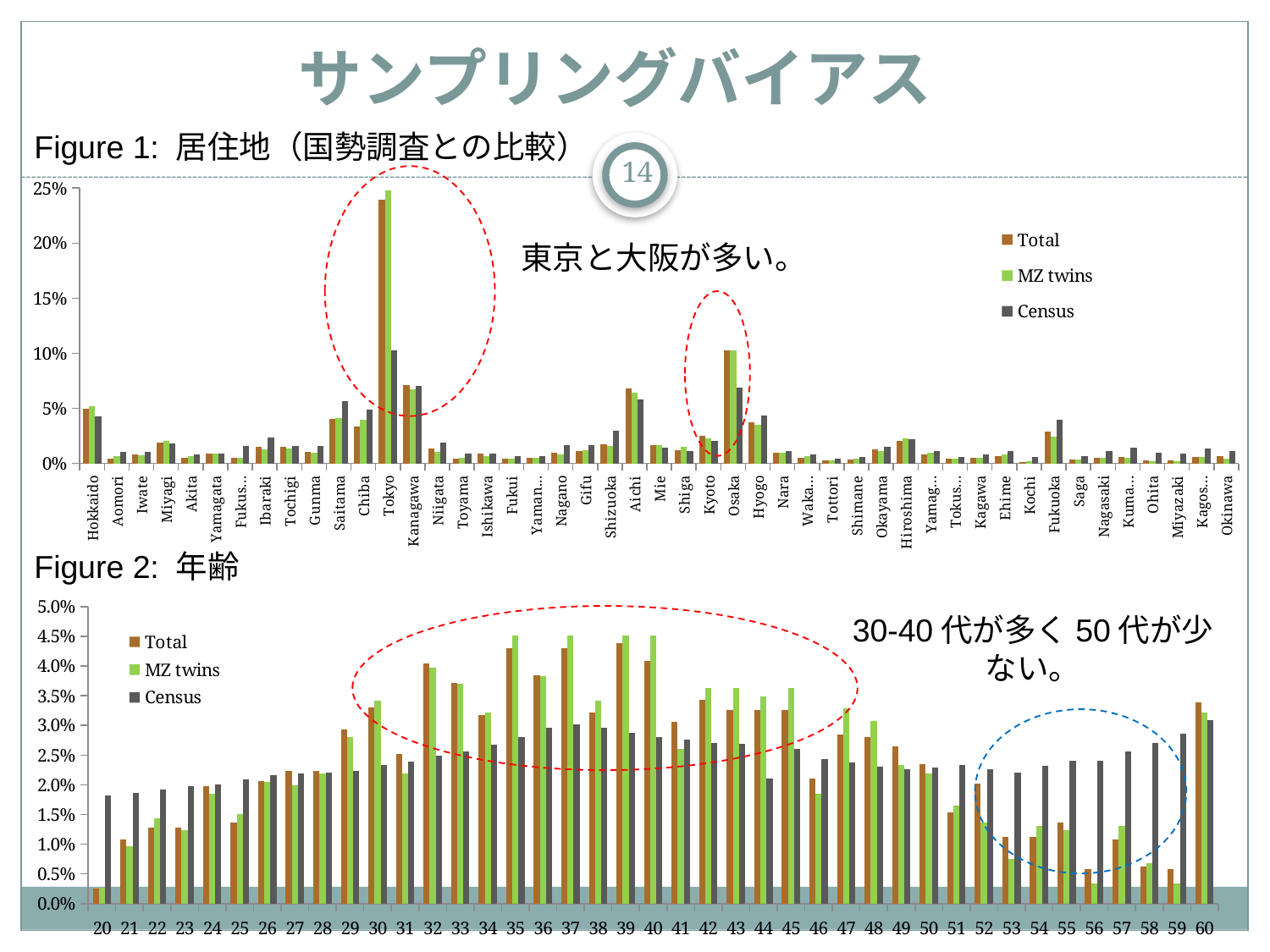
In Figure 2 (年齢), is the Total value for age 32 greater or less than 3.5%? greater What kind of chart is Figure 2 (年齢)? bar chart In Figure 2 (年齢), how many age categories are shown on the x axis? 41 In Figure 1 (居住地), is the Total value for Tokyo greater or less than 20%? greater In Figure 1 (居住地), how many prefectures are shown on the x axis? 47 In Figure 1 (居住地), which prefecture has the highest Total value? Tokyo In Figure 1 (居住地), how many series does the legend list? 3 What kind of chart is Figure 1 (居住地)? bar chart In Figure 1 (居住地), which is larger for Tokyo: the Total value or the Census value? Total In Figure 1 (居住地), is the Total value for Osaka greater or less than 5%? greater In Figure 2 (年齢), which is larger at age 58: the Total value or the Census value? Census In Figure 2 (年齢), what are the three legend entries? Total, MZ twins, Census